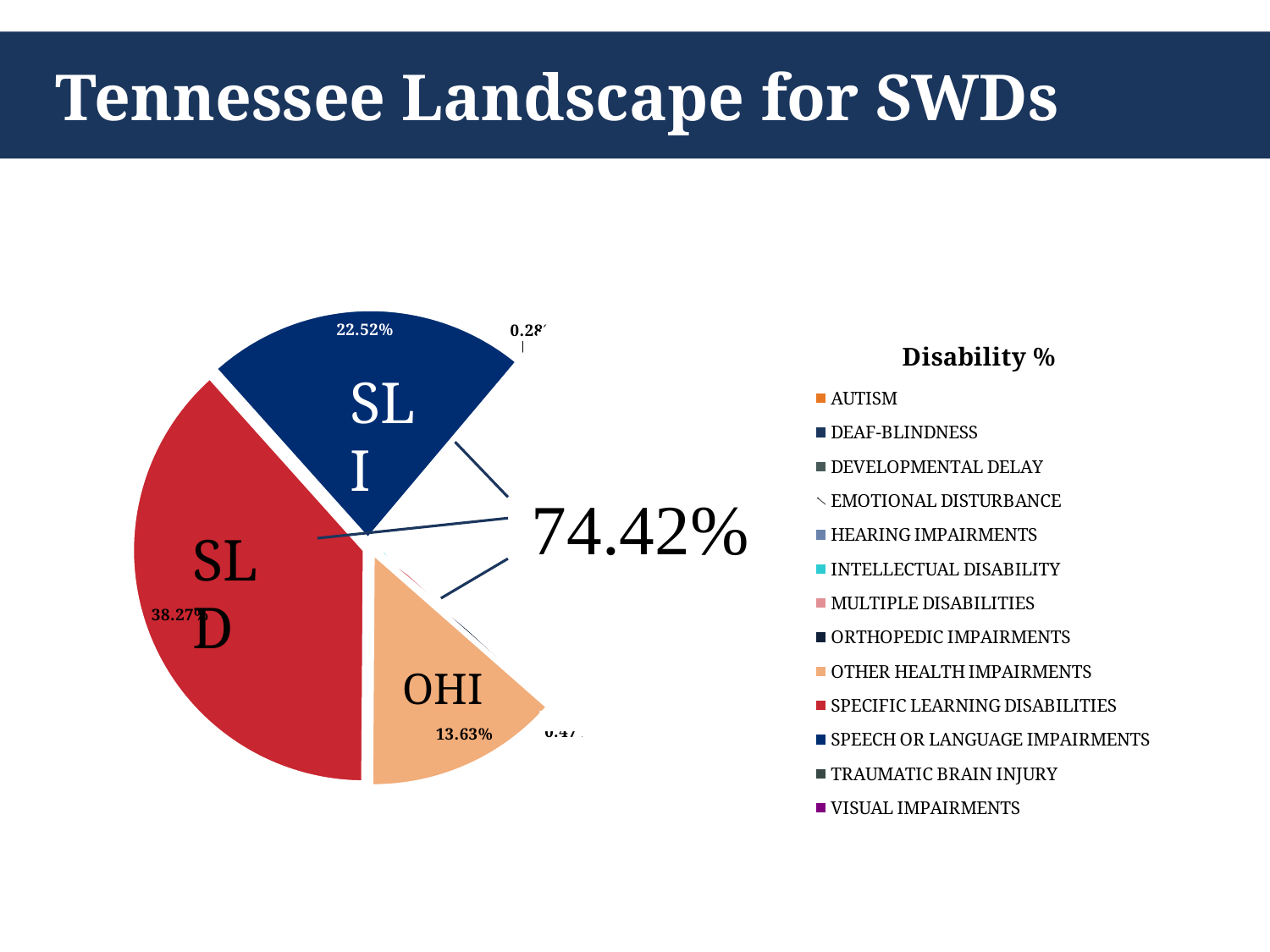
What kind of chart is shown on the slide? pie chart What is the difference between the SLI share and the OHI share? 8.89% What combined percentage is shown for the SLD, SLI and OHI slices together? 74.42% What colour is the Specific Learning Disabilities slice? red What percentage is shown for Other Health Impairments (OHI)? 13.63% How many disability categories does the legend list? 13 What percentage is shown for Specific Learning Disabilities (SLD)? 38.27% Which is larger, the share for SLD or the share for SLI? SLD What is the difference between the SLD share and the SLI share? 15.75% What is the title of the chart's legend? Disability % Which disability category has the largest slice of the pie? Specific Learning Disabilities What percentage is shown for Speech or Language Impairments (SLI)? 22.52%